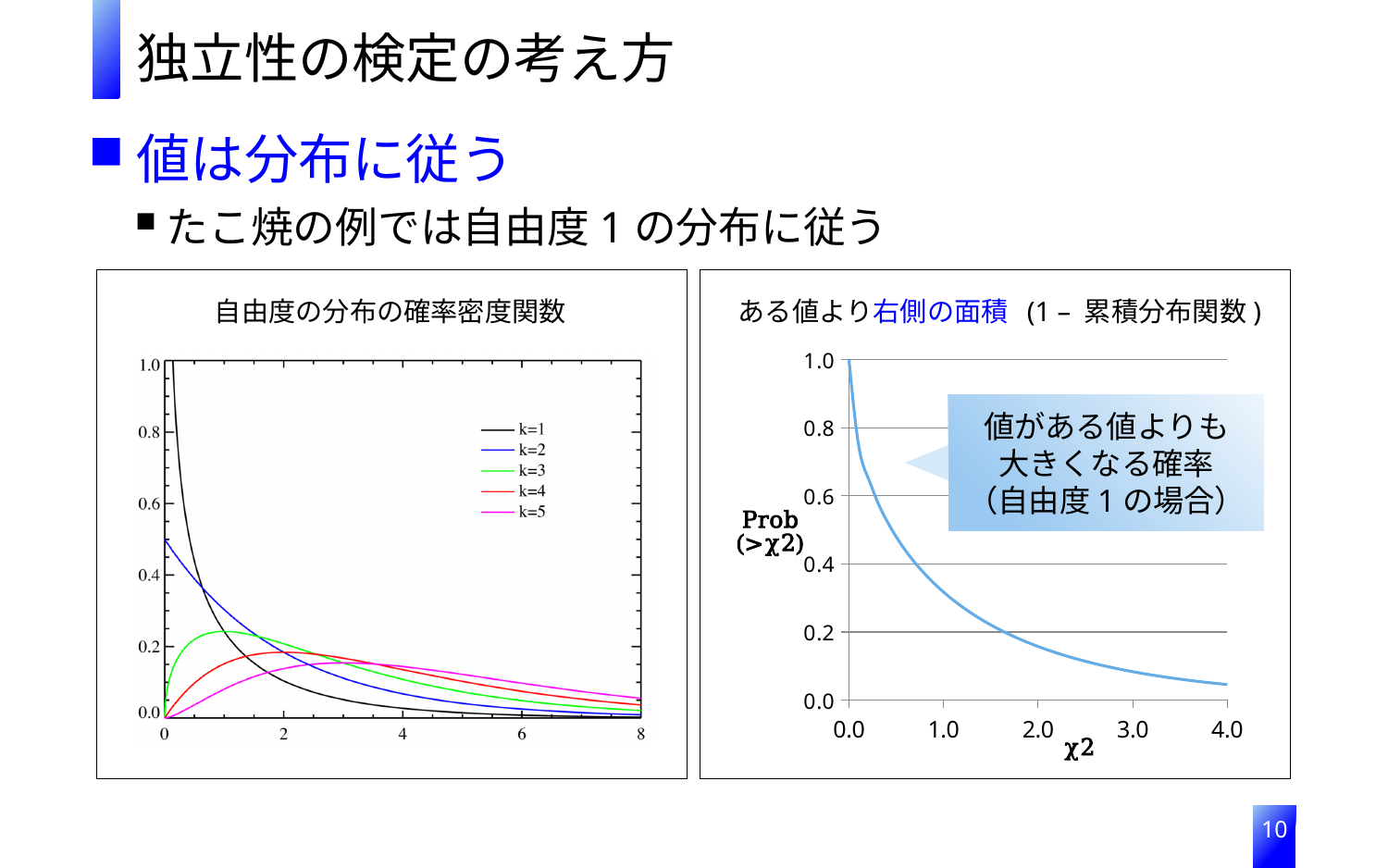
In the right chart (ある値より右側の面積), what is the value of Prob(>χ2) at χ2 = 0.0? 1.0 In the left chart (自由度の分布の確率密度関数), what colour is the k=1 line? black What kind of chart is the left chart titled 自由度の分布の確率密度関数? line chart What kind of chart is the right chart titled ある値より右側の面積（1 – 累積分布関数）? line chart In the left chart (自由度の分布の確率密度関数), which series has its peak furthest to the right along the x axis? k=5 In the left chart (自由度の分布の確率密度関数), does the k=1 curve rise or fall as the x value increases? fall In the right chart (ある値より右側の面積), does the curve rise or fall as χ2 increases? fall How many series does the legend of the left chart (自由度の分布の確率密度関数) list? 5 In the right chart (ある値より右側の面積), is the value of Prob(>χ2) at χ2 = 4.0 greater or less than 0.2? less In the right chart (ある値より右側の面積), is the value of Prob(>χ2) at χ2 = 1.0 greater or less than 0.4? less In the left chart (自由度の分布の確率密度関数), is the peak value of the k=5 curve greater or less than 0.2? less